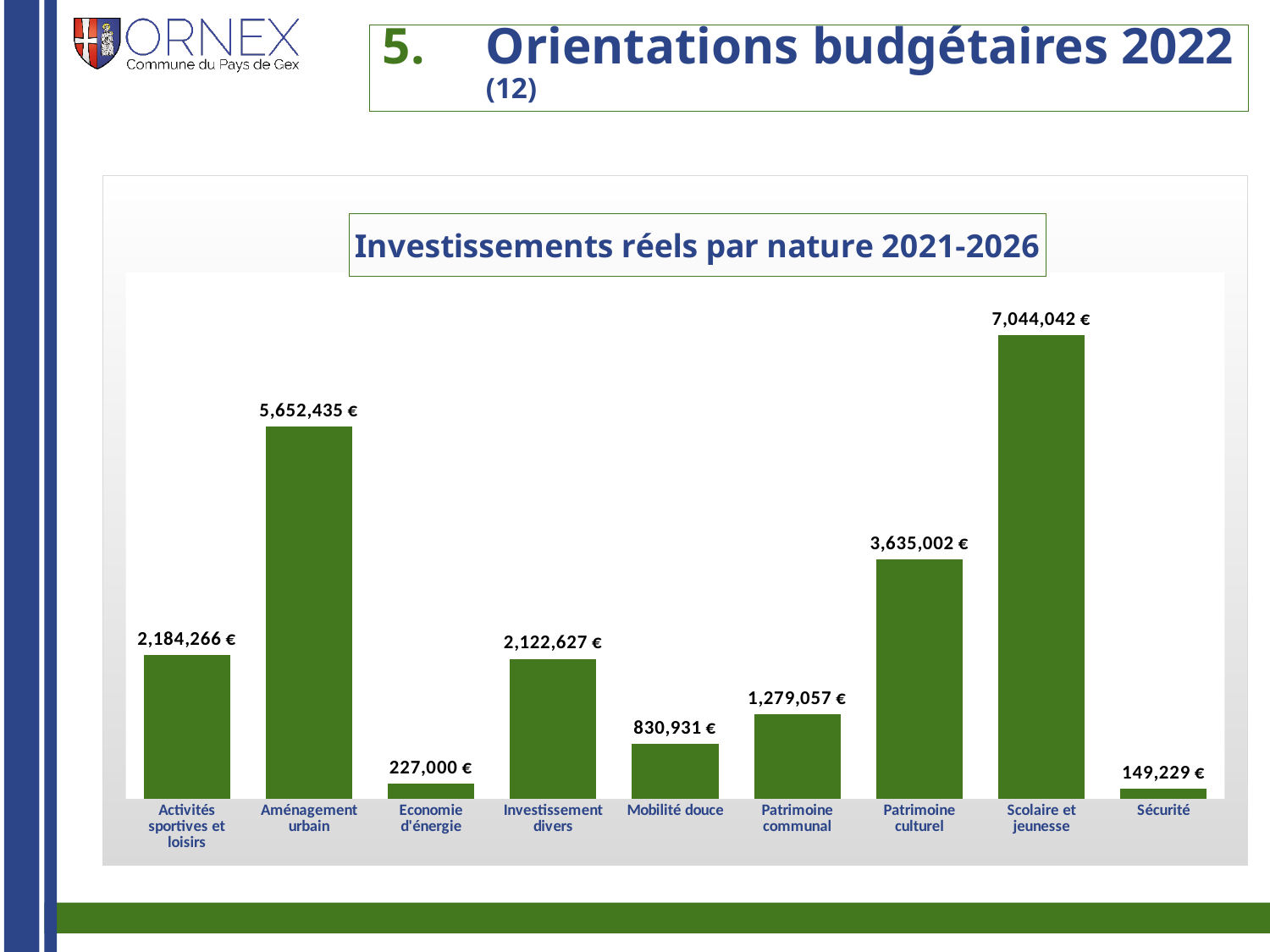
Which is larger, the value for Activités sportives et loisirs or the value for Investissement divers? Activités sportives et loisirs What is the value for Economie d'énergie? 227,000 € What is the value for Scolaire et jeunesse? 7,044,042 € What is the title of the chart? Investissements réels par nature 2021-2026 Which category has the lowest value? Sécurité What is the value for Mobilité douce? 830,931 € How many categories are shown in the chart? 9 What is the value for Patrimoine communal? 1,279,057 € What is the difference between the values for Scolaire et jeunesse and Aménagement urbain? 1,391,607 € Which category has the highest value? Scolaire et jeunesse What kind of chart is shown on the slide? Bar chart What is the difference between the values for Patrimoine culturel and Patrimoine communal? 2,355,945 €